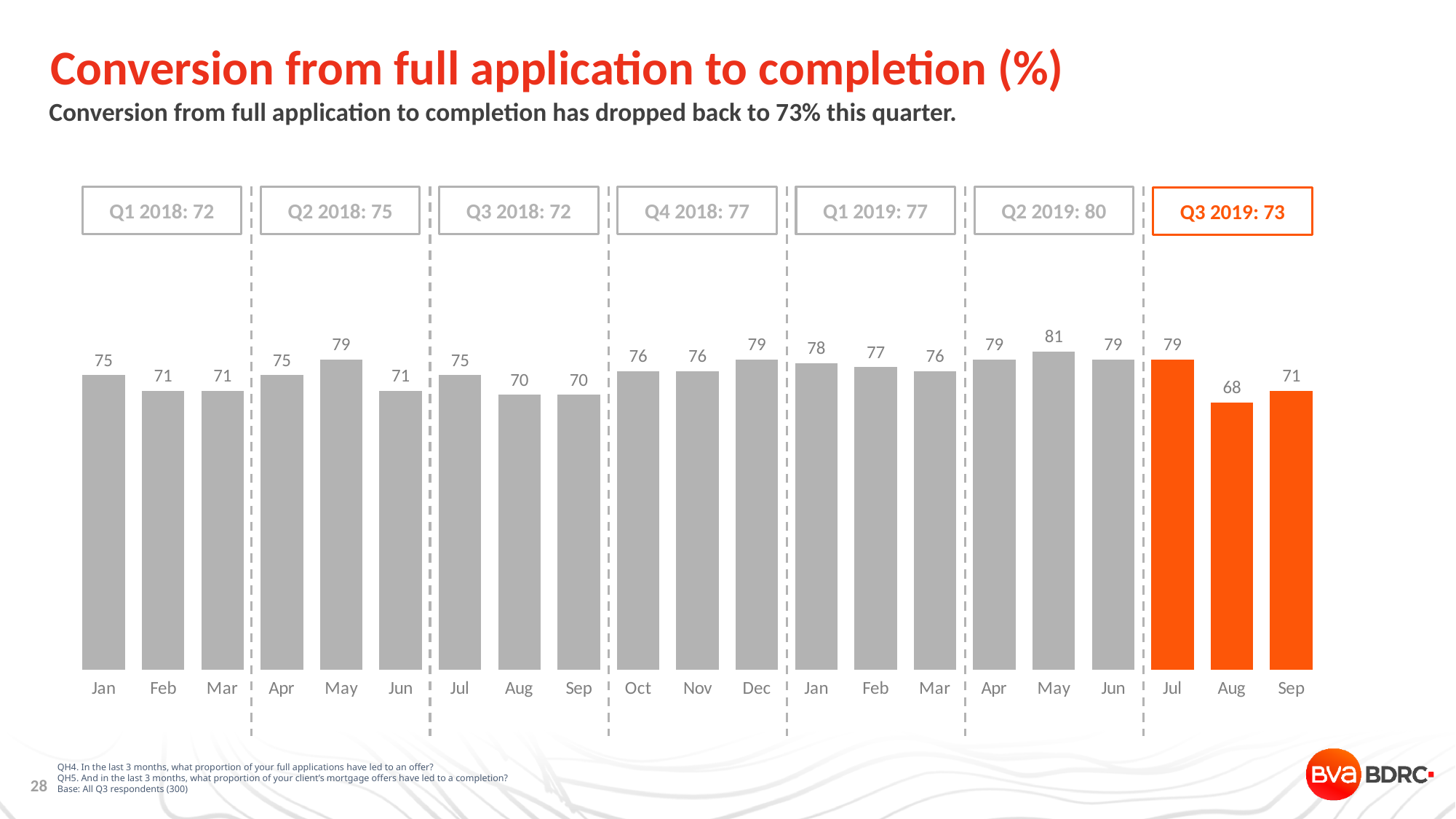
Which quarter's bars are highlighted in orange? Q3 2019 What is the value for Dec 2018? 79 What quarterly figure is shown in the box for Q2 2019? 80 What is the value for Aug 2019 (in the Q3 2019 section)? 68 Which is larger, the value for Jan 2018 or the value for Jan 2019? Jan 2019 Which month has the highest value on the chart? May 2019 What is the value for May 2019 (in the Q2 2019 section)? 81 Which month has the lowest value on the chart? Aug 2019 What kind of chart is shown on the slide? Bar chart How many monthly bars are plotted on the chart? 21 What is the difference between the values for Jul 2019 and Aug 2019? 11 Do the values rise or fall from Jul 2019 to Aug 2019? Fall